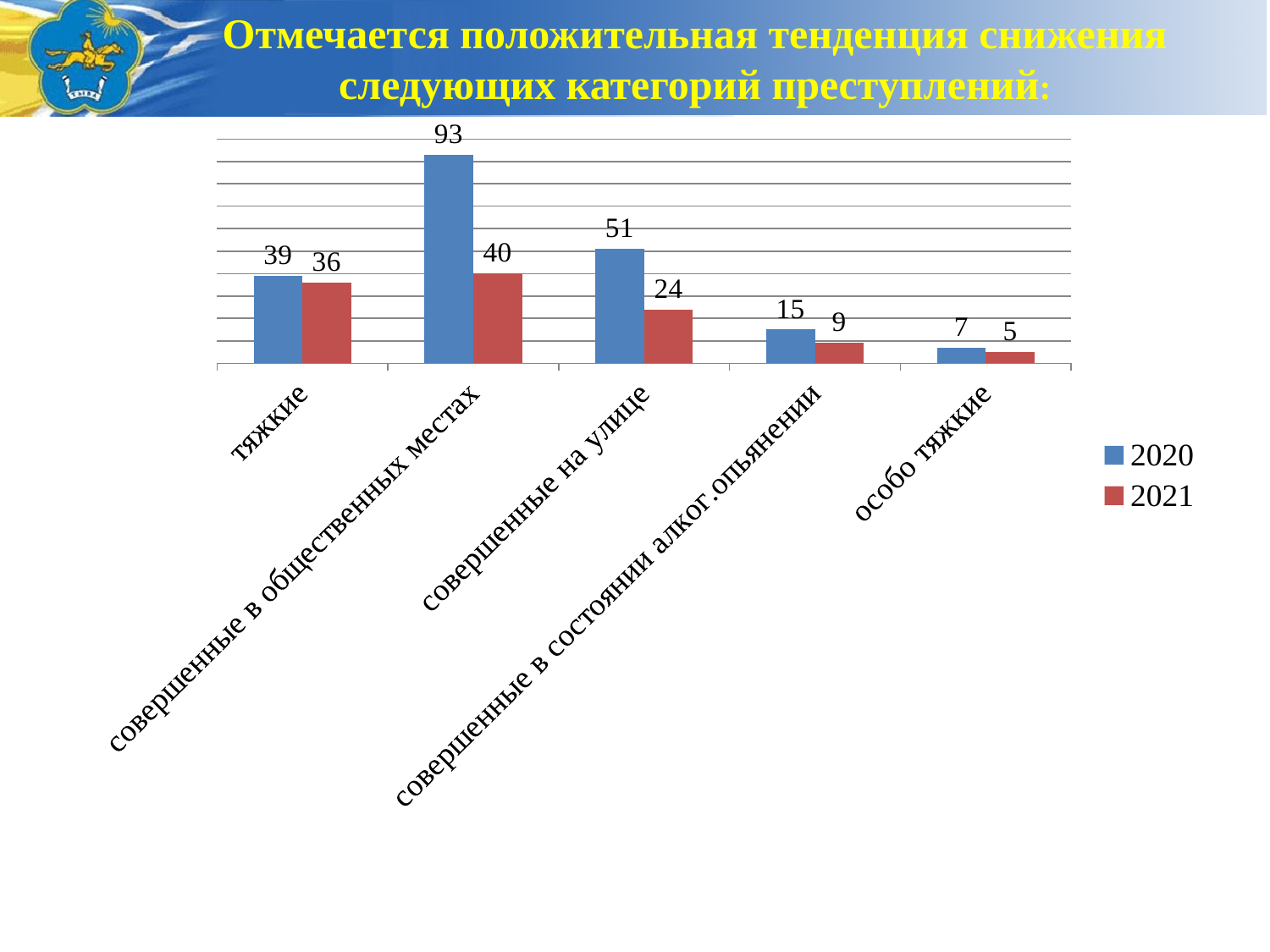
What is the 2021 value for "тяжкие"? 36 What is the 2020 value for "совершенные в состоянии алког.опьянении"? 15 Which category has the lowest 2021 value? особо тяжкие How many categories are shown on the x axis? 5 What kind of chart is shown on the slide? bar chart What is the 2020 value for "совершенные в общественных местах"? 93 How many series does the legend list? 2 What is the difference between the 2020 and 2021 values for "совершенные на улице"? 27 Which is larger: the 2020 value for "тяжкие" or the 2021 value for "совершенные в общественных местах"? 2021 value for совершенные в общественных местах What is the 2021 value for "совершенные на улице"? 24 Which category has the highest 2020 value? совершенные в общественных местах What is the difference between the 2020 and 2021 values for "совершенные в общественных местах"? 53